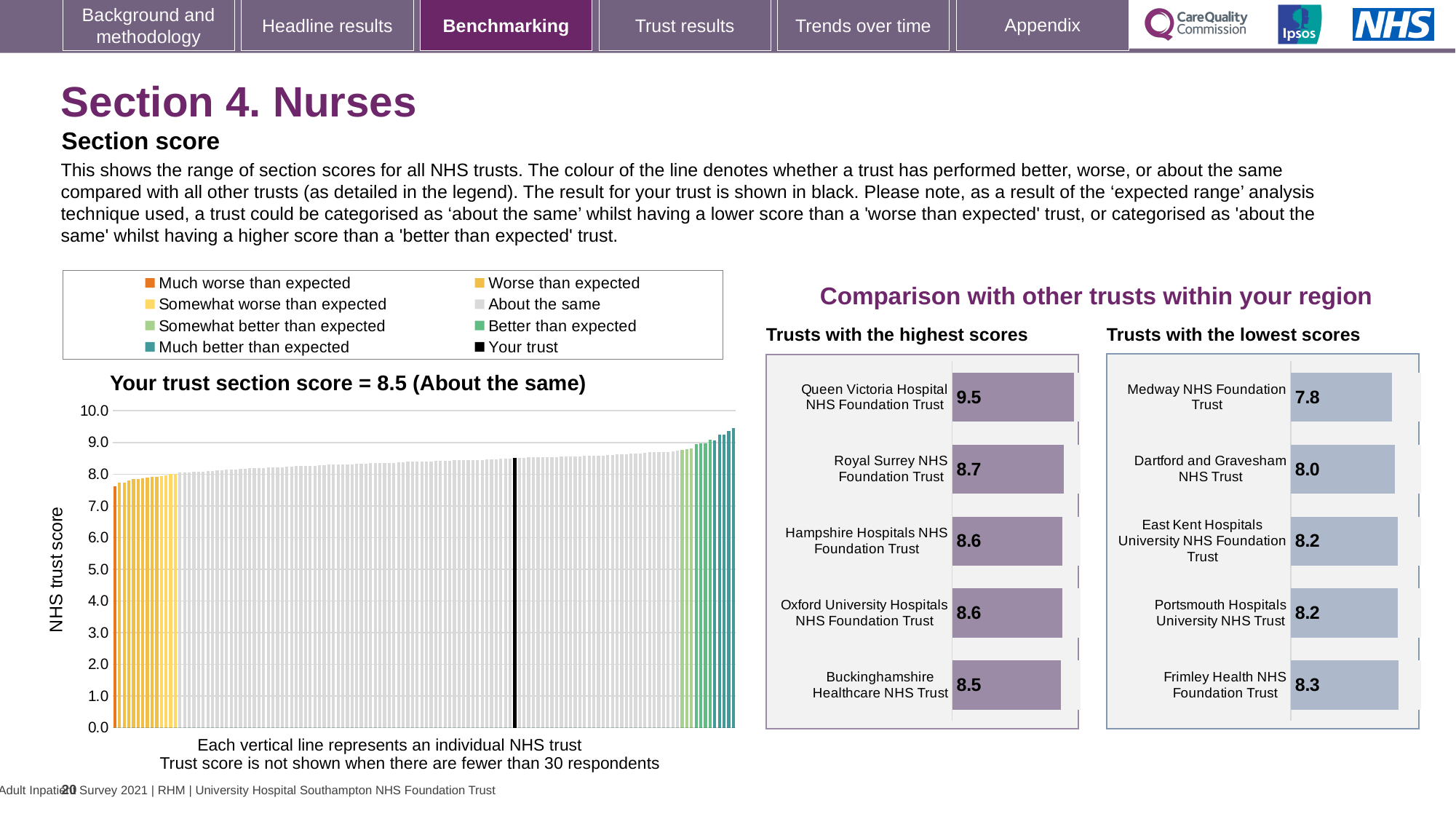
In the 'Trusts with the lowest scores' chart, which trust has the lowest score? Medway NHS Foundation Trust In the 'Trusts with the highest scores' chart, what is the difference between the scores of Queen Victoria Hospital NHS Foundation Trust and Royal Surrey NHS Foundation Trust? 0.8 In the 'Trusts with the highest scores' chart, which trust has the highest score? Queen Victoria Hospital NHS Foundation Trust In the 'Trusts with the lowest scores' chart, what is the score for Medway NHS Foundation Trust? 7.8 What kind of chart is the 'Trusts with the lowest scores' chart? Bar chart According to the title of the main chart on the left, what is your trust's section score? 8.5 In the 'Trusts with the lowest scores' chart, which has the larger score: Frimley Health NHS Foundation Trust or Dartford and Gravesham NHS Trust? Frimley Health NHS Foundation Trust How many trusts are shown in the 'Trusts with the highest scores' chart? 5 How many entries does the legend above the main chart on the left list? 8 In the 'Trusts with the highest scores' chart, what is the score for Hampshire Hospitals NHS Foundation Trust? 8.6 In the 'Trusts with the highest scores' chart, what is the score for Queen Victoria Hospital NHS Foundation Trust? 9.5 In the 'Trusts with the lowest scores' chart, what is the difference between the scores of Frimley Health NHS Foundation Trust and Medway NHS Foundation Trust? 0.5